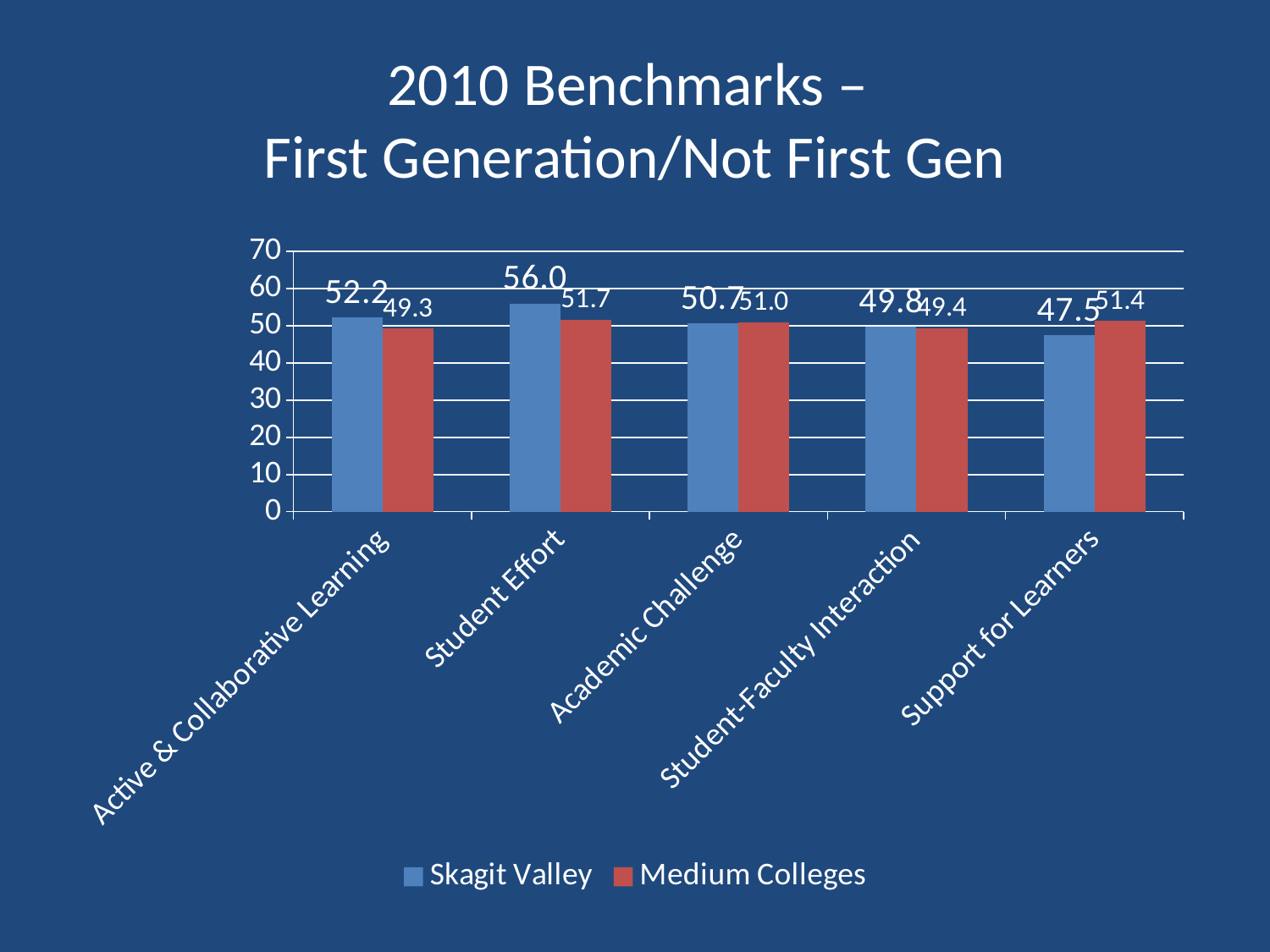
What kind of chart is shown on the slide? Bar chart For Student Effort, which is larger: the Skagit Valley value or the Medium Colleges value? Skagit Valley How many categories are shown on the x axis? 5 What is the Medium Colleges value for Support for Learners? 51.4 What is the Skagit Valley value for Active & Collaborative Learning? 52.2 What is the Skagit Valley value for Student Effort? 56.0 What is the difference between the Skagit Valley and Medium Colleges values for Support for Learners? 3.9 How many series does the legend list? 2 Which series is shown in red in the legend? Medium Colleges Which category has the highest Skagit Valley value? Student Effort Which category has the lowest Skagit Valley value? Support for Learners What is the Medium Colleges value for Academic Challenge? 51.0